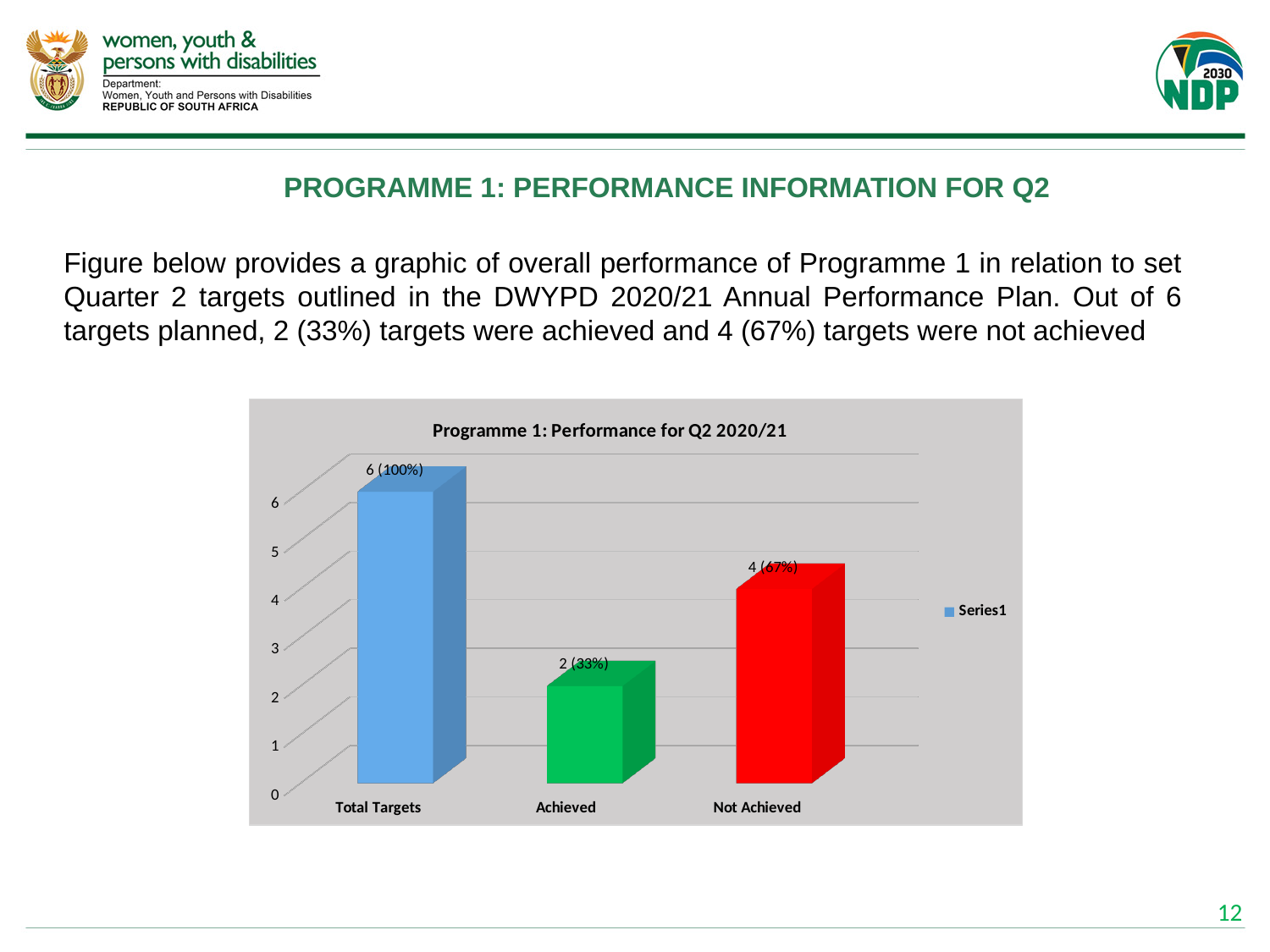
What kind of chart is shown? Bar chart What is the value shown for Not Achieved? 4 (67%) What is the value shown for Achieved? 2 (33%) Which is larger, the value for Achieved or the value for Not Achieved? Not Achieved What is the difference between the number of targets Not Achieved and the number Achieved? 2 Which category has the lowest value? Achieved Which category has the highest value? Total Targets What is the value shown for Total Targets? 6 (100%) Is the value for Not Achieved greater or less than 3? greater How many series does the legend list? 1 What is the title of the chart? Programme 1: Performance for Q2 2020/21 How many categories are shown on the x axis? 3